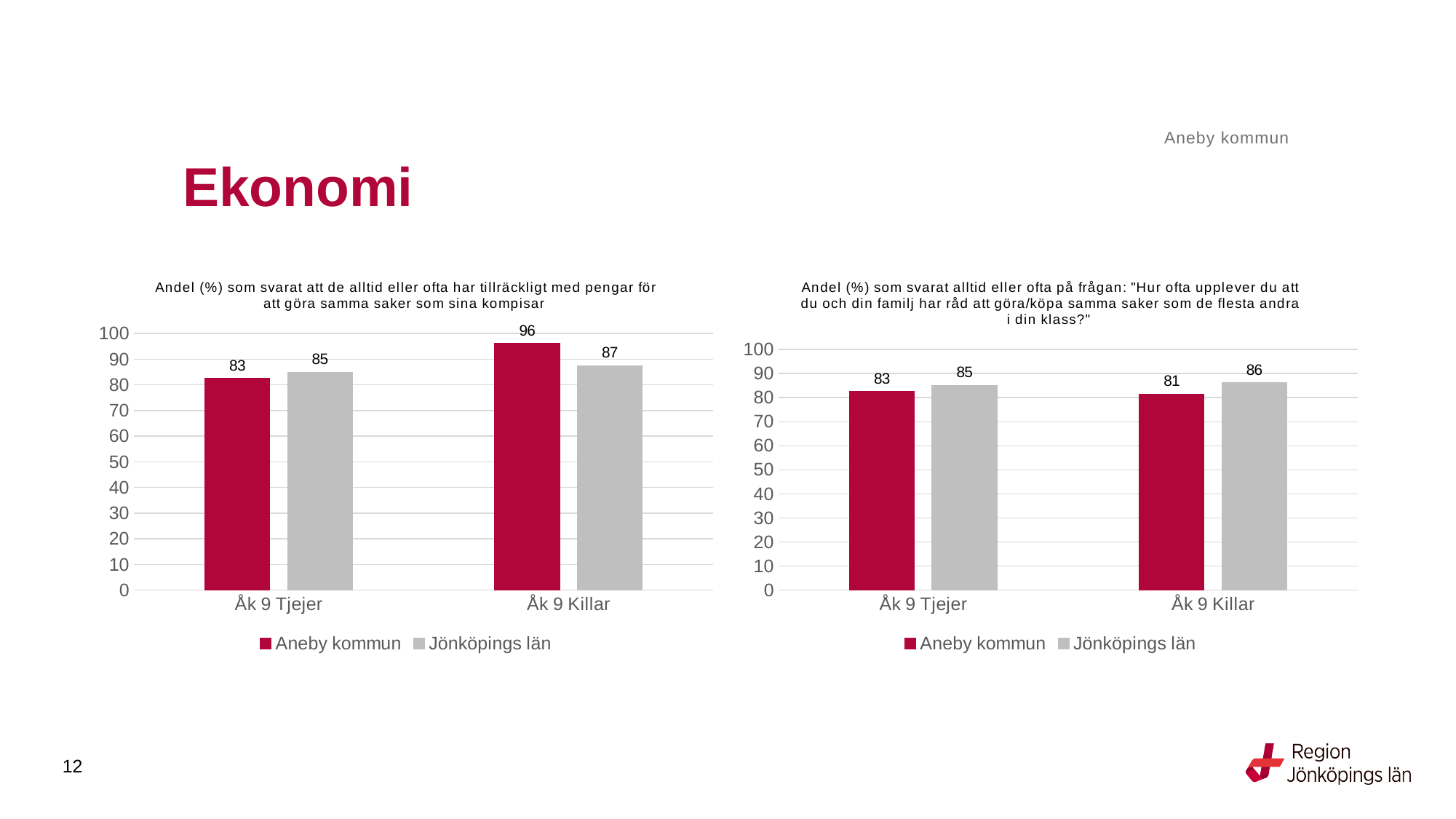
In the right chart, what is the difference between Jönköpings län and Aneby kommun for Åk 9 Killar? 5 In the left chart, what is the difference between Aneby kommun and Jönköpings län for Åk 9 Killar? 9 In the left chart, what is the value for Aneby kommun for Åk 9 Killar? 96 In the right chart, what is the value for Aneby kommun for Åk 9 Killar? 81 In the left chart, what is the value for Jönköpings län for Åk 9 Tjejer? 85 How many categories are shown on the x axis of the right chart? 2 What kind of chart is the left chart? Bar chart In the right chart, which bar has the lowest value? Aneby kommun, Åk 9 Killar In the right chart, which is larger for Åk 9 Tjejer: Aneby kommun or Jönköpings län? Jönköpings län In the right chart, what is the value for Jönköpings län for Åk 9 Killar? 86 How many series does the legend of the left chart list? 2 In the left chart, which bar has the highest value? Aneby kommun, Åk 9 Killar